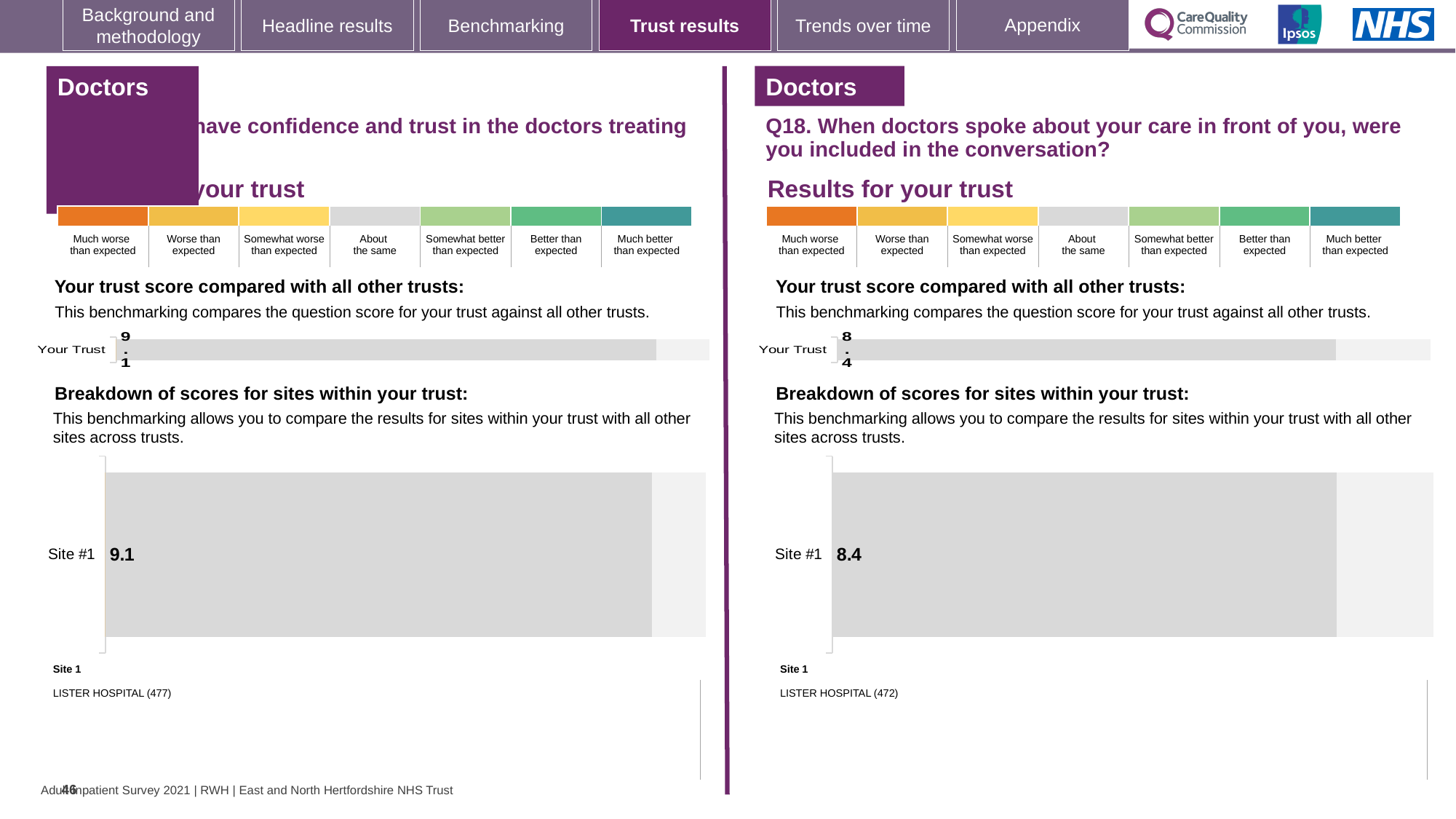
On the left half of the slide, what is the score shown for Site #1? 9.1 What type of chart is used to show the Site #1 score on the left half of the slide? Bar chart On the right half of the slide (Q18), what is the score shown for Site #1? 8.4 On the right half of the slide (Q18), which hospital is listed as Site 1? LISTER HOSPITAL (472) What is the difference between the Site #1 score on the left half of the slide and the Site #1 score on the right half (Q18)? 0.7 What is the difference between the Your Trust score on the left half of the slide and the Your Trust score on the right half (Q18)? 0.7 Which is larger: the Your Trust score on the left half of the slide or the Your Trust score on the right half (Q18)? Left half (9.1) On the right half of the slide (Q18), what is the score shown for Your Trust? 8.4 On the left half of the slide, which hospital is listed as Site 1? LISTER HOSPITAL (477) On the right half of the slide (Q18), is the Site #1 score the same as the Your Trust score? Yes, both are 8.4 On the right half of the slide (Q18), how many sites are shown in the breakdown of scores for sites within your trust? 1 On the left half of the slide, what is the score shown for Your Trust? 9.1